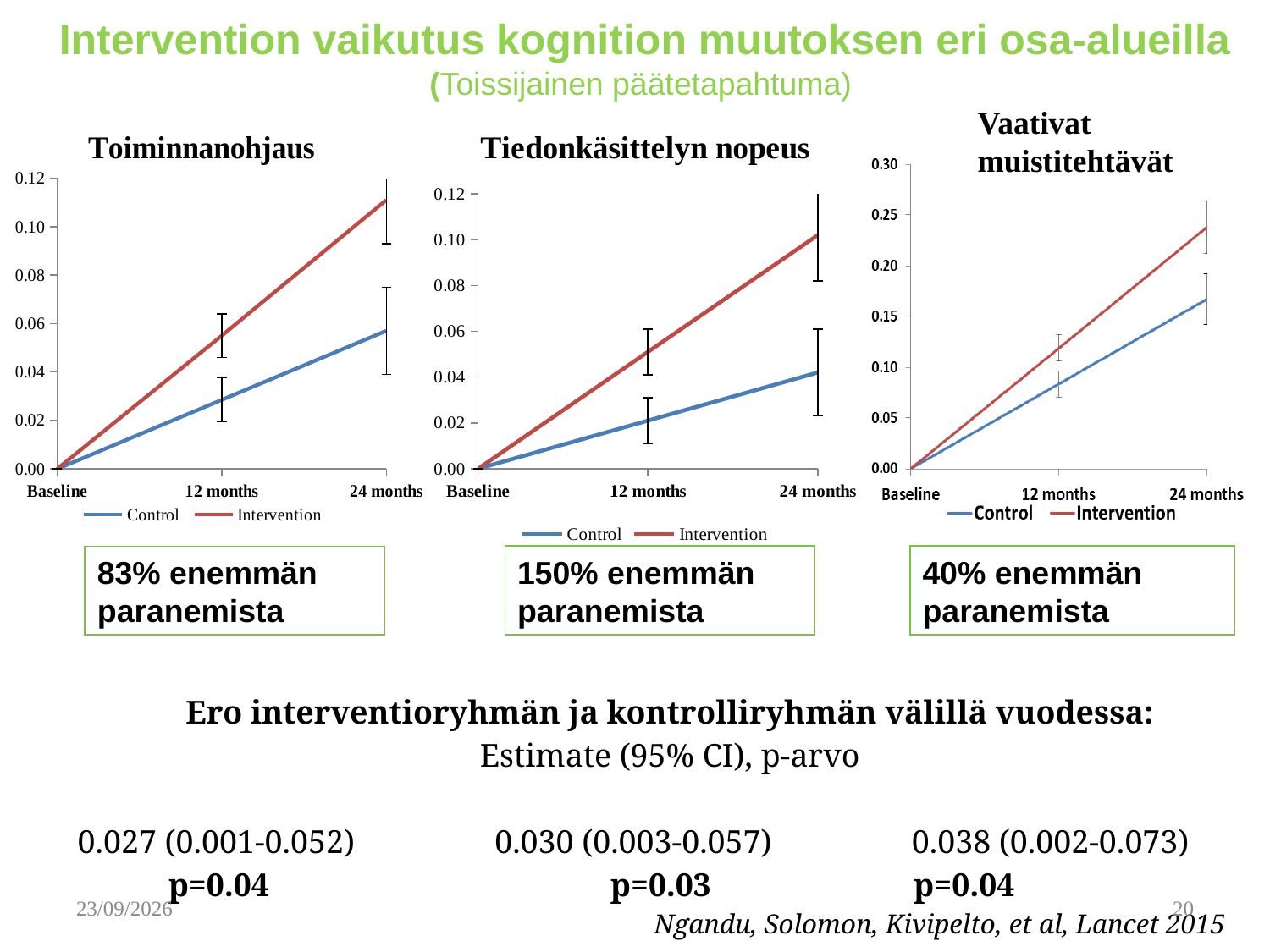
In the "Toiminnanohjaus" chart, what colour is the Intervention line? Red In the "Toiminnanohjaus" chart, is the Intervention value at 24 months greater or less than 0.10? greater In the "Tiedonkäsittelyn nopeus" chart, is the Control value at 24 months greater or less than 0.06? less In the "Vaativat muistitehtävät" chart, is the Intervention value at 24 months greater or less than 0.20? greater In the "Vaativat muistitehtävät" chart, do the Control and Intervention lines rise or fall from Baseline to 24 months? Rise In the "Tiedonkäsittelyn nopeus" chart, what is the value of both series at Baseline? 0.00 How many time points are shown on the x axis of the "Vaativat muistitehtävät" chart? 3 How many series does the legend of the "Tiedonkäsittelyn nopeus" chart list? 2 In the "Toiminnanohjaus" chart, which series is higher at 24 months, Control or Intervention? Intervention What kind of chart is the "Toiminnanohjaus" chart? Line chart